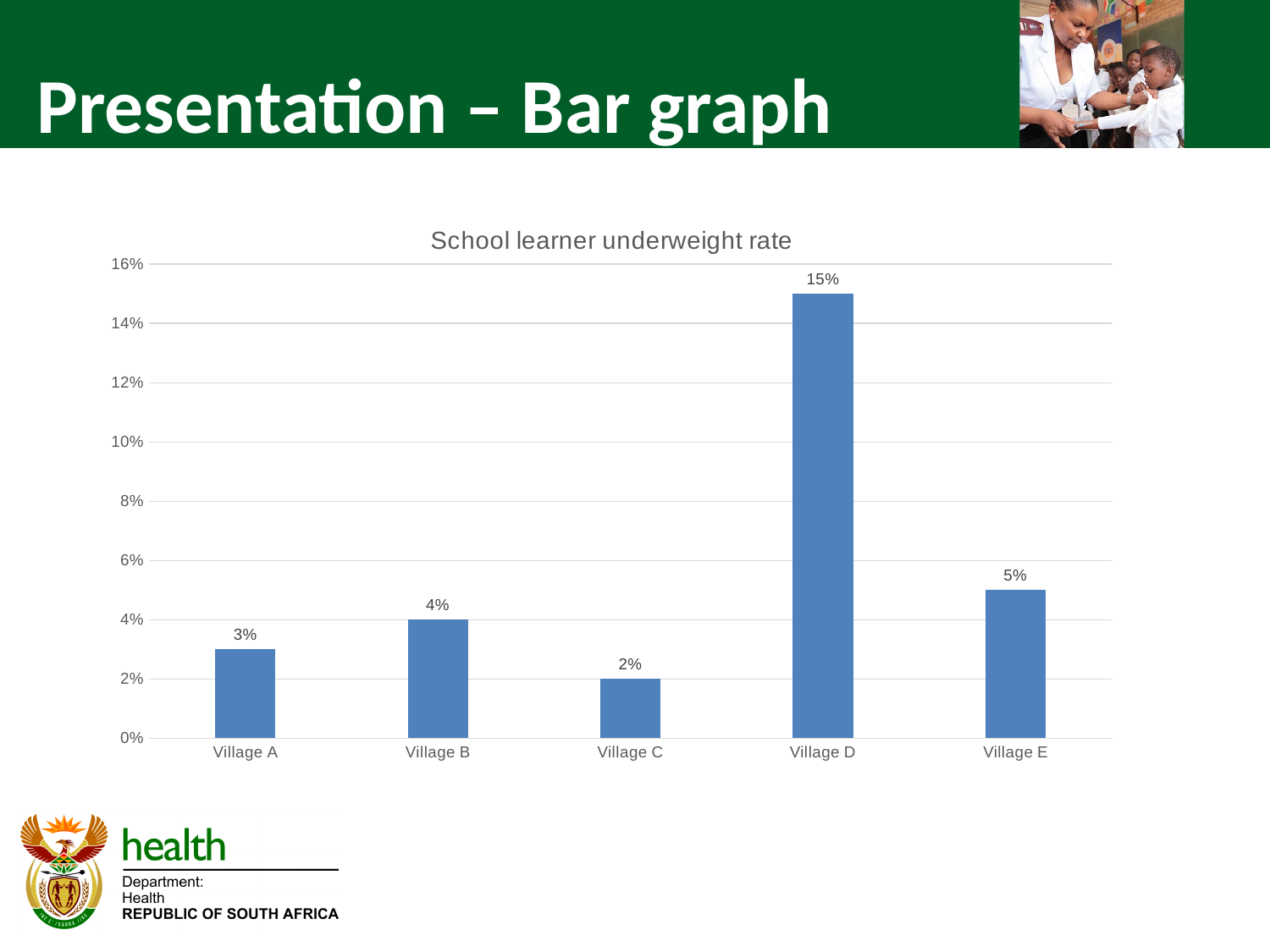
What is the difference between the underweight rates of Village B and Village C? 2% What is the school learner underweight rate for Village D? 15% What kind of chart is shown on the slide? Bar chart How many villages are shown in the chart? 5 Is the value for Village D greater or less than 10%? greater What is the title of the chart? School learner underweight rate What is the school learner underweight rate for Village A? 3% What is the difference between the underweight rates of Village D and Village E? 10% What is the school learner underweight rate for Village E? 5% Which village has the lowest underweight rate? Village C Which has a higher underweight rate, Village B or Village A? Village B Which village has the highest underweight rate? Village D